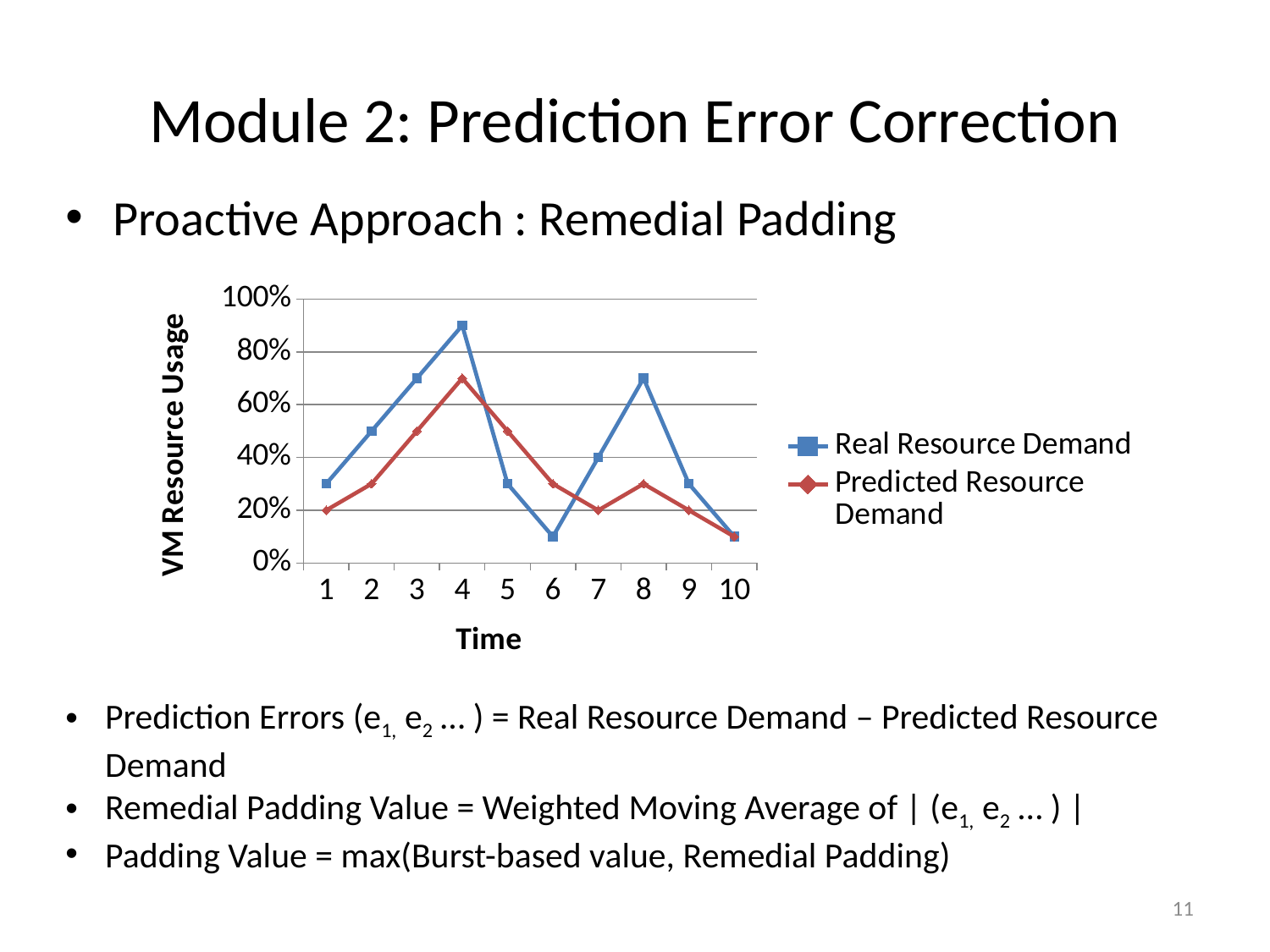
At time 5, which is larger: Real Resource Demand or Predicted Resource Demand? Predicted Resource Demand How many time points are plotted along the x axis? 10 At which time does Predicted Resource Demand reach its highest value? 4 At which time does Real Resource Demand reach its highest value? 4 Is the value for Real Resource Demand at time 8 greater or less than 60%? greater Is the value for Real Resource Demand at time 4 greater or less than 80%? greater What kind of chart is shown on the slide? line chart How many series does the legend list? 2 At which time is Predicted Resource Demand lowest? 10 What is the label of the y axis? VM Resource Usage Is the value for Predicted Resource Demand at time 6 greater or less than 40%? less Does Real Resource Demand rise or fall from time 1 to time 4? rise